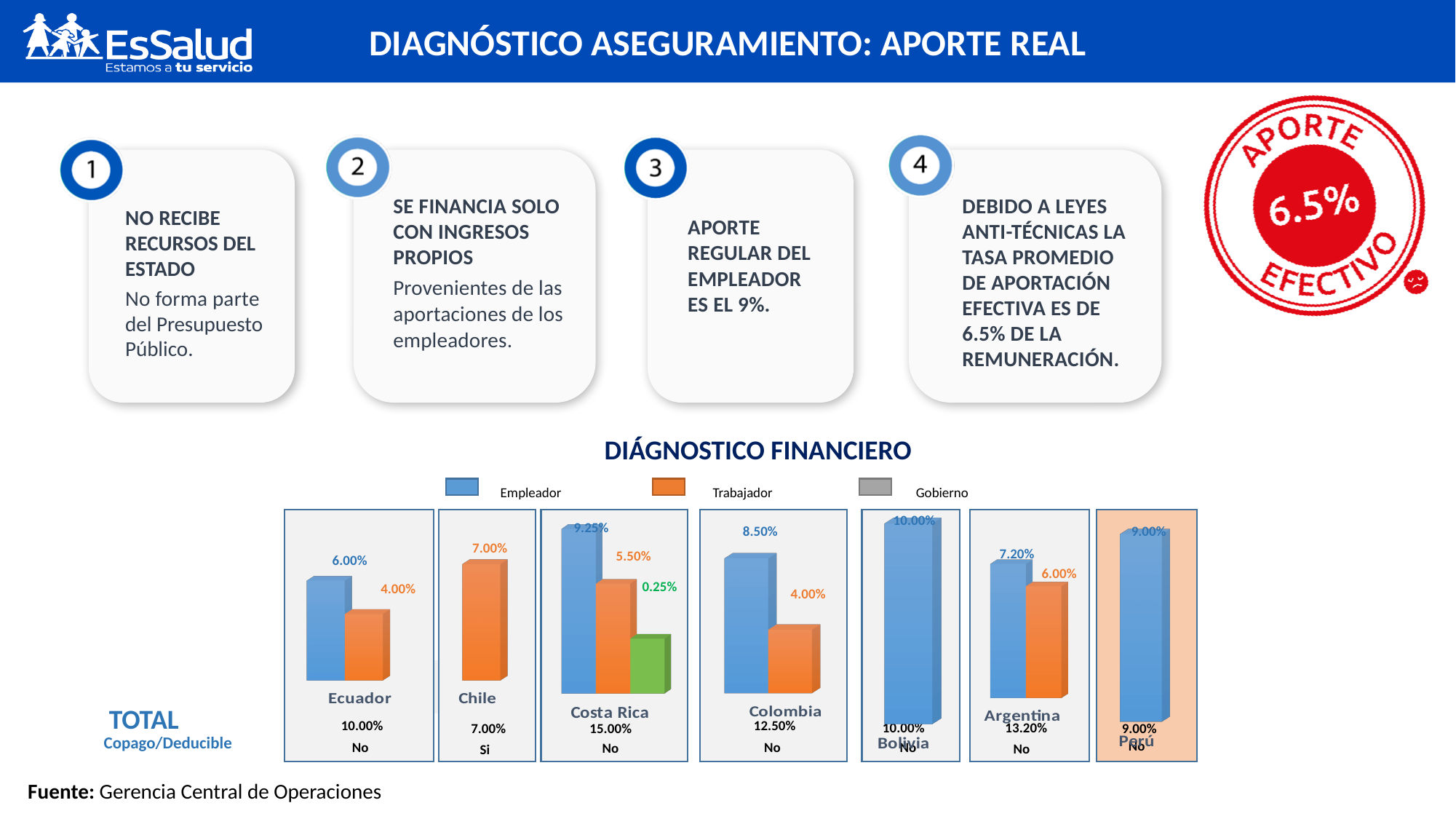
In the DIÁGNOSTICO FINANCIERO chart, what is the Gobierno value for Costa Rica? 0.25% In the DIÁGNOSTICO FINANCIERO chart, which colour represents the Trabajador series? Orange How many series does the legend of the DIÁGNOSTICO FINANCIERO chart list? 3 In the DIÁGNOSTICO FINANCIERO chart, what is the Trabajador value for Chile? 7.00% What kind of chart is the DIÁGNOSTICO FINANCIERO chart? Bar chart In the DIÁGNOSTICO FINANCIERO chart, what is the difference between the Empleador and Trabajador values for Argentina? 1.20% In the DIÁGNOSTICO FINANCIERO chart, which country has the highest Empleador value? Bolivia In the DIÁGNOSTICO FINANCIERO chart, which country has the lowest Empleador value among those with an Empleador bar? Ecuador How many countries are shown in the DIÁGNOSTICO FINANCIERO chart? 7 In the DIÁGNOSTICO FINANCIERO chart, what is the Empleador value for Costa Rica? 9.25% In the DIÁGNOSTICO FINANCIERO chart, which is larger: the Empleador value for Colombia or the Empleador value for Perú? Perú In the DIÁGNOSTICO FINANCIERO chart, what is the TOTAL shown for Costa Rica? 15.00%